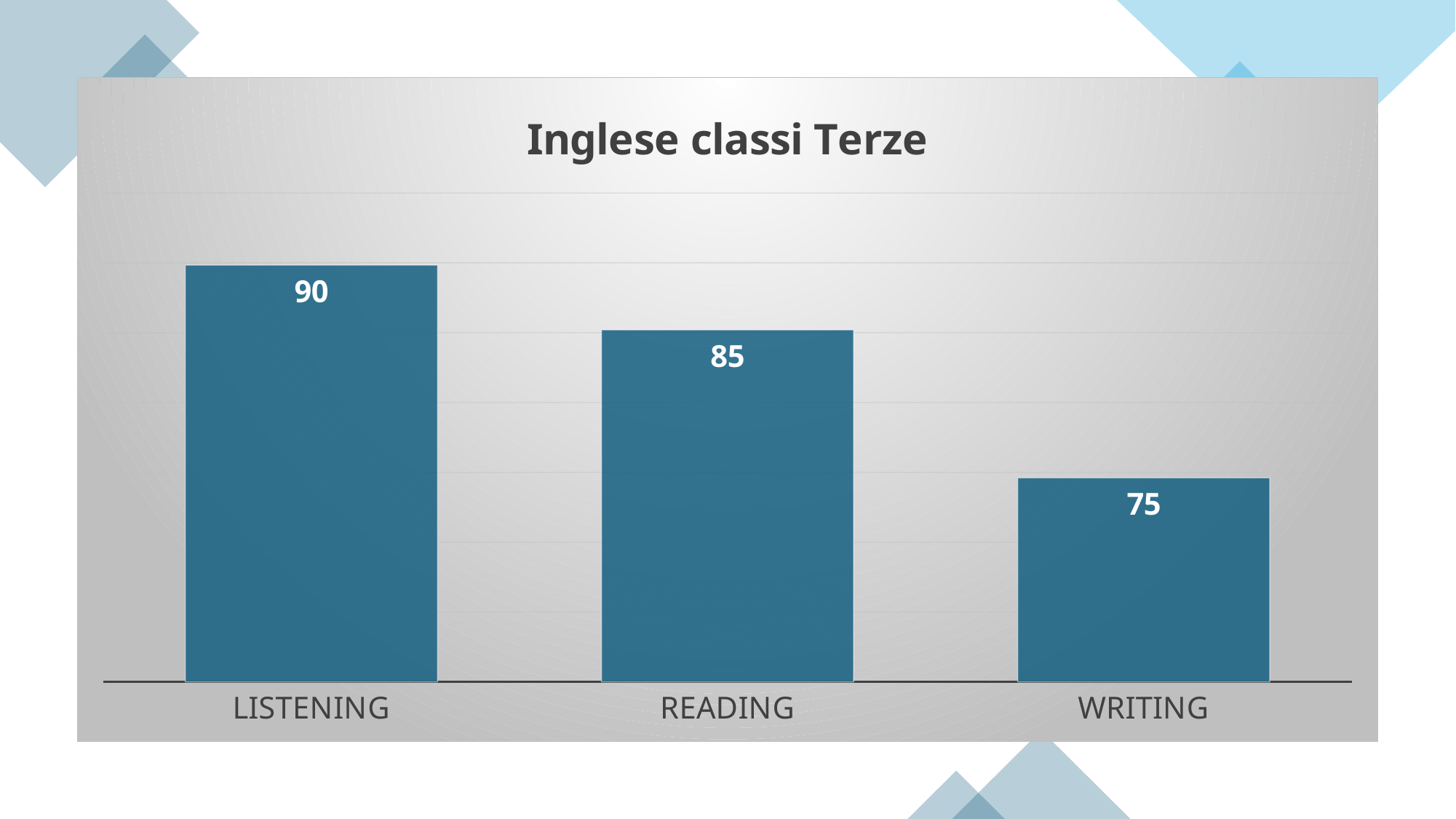
Do the values rise or fall from LISTENING to WRITING? fall What kind of chart is shown on the slide? bar chart Which category has the highest value? LISTENING What is the value for READING? 85 Which category has the lowest value? WRITING What is the value for WRITING? 75 What is the value for LISTENING? 90 What is the difference between the values for LISTENING and WRITING? 15 What is the title of the chart? Inglese classi Terze What is the difference between the values for READING and WRITING? 10 How many categories are shown in the chart? 3 Which is larger, the value for READING or the value for WRITING? READING